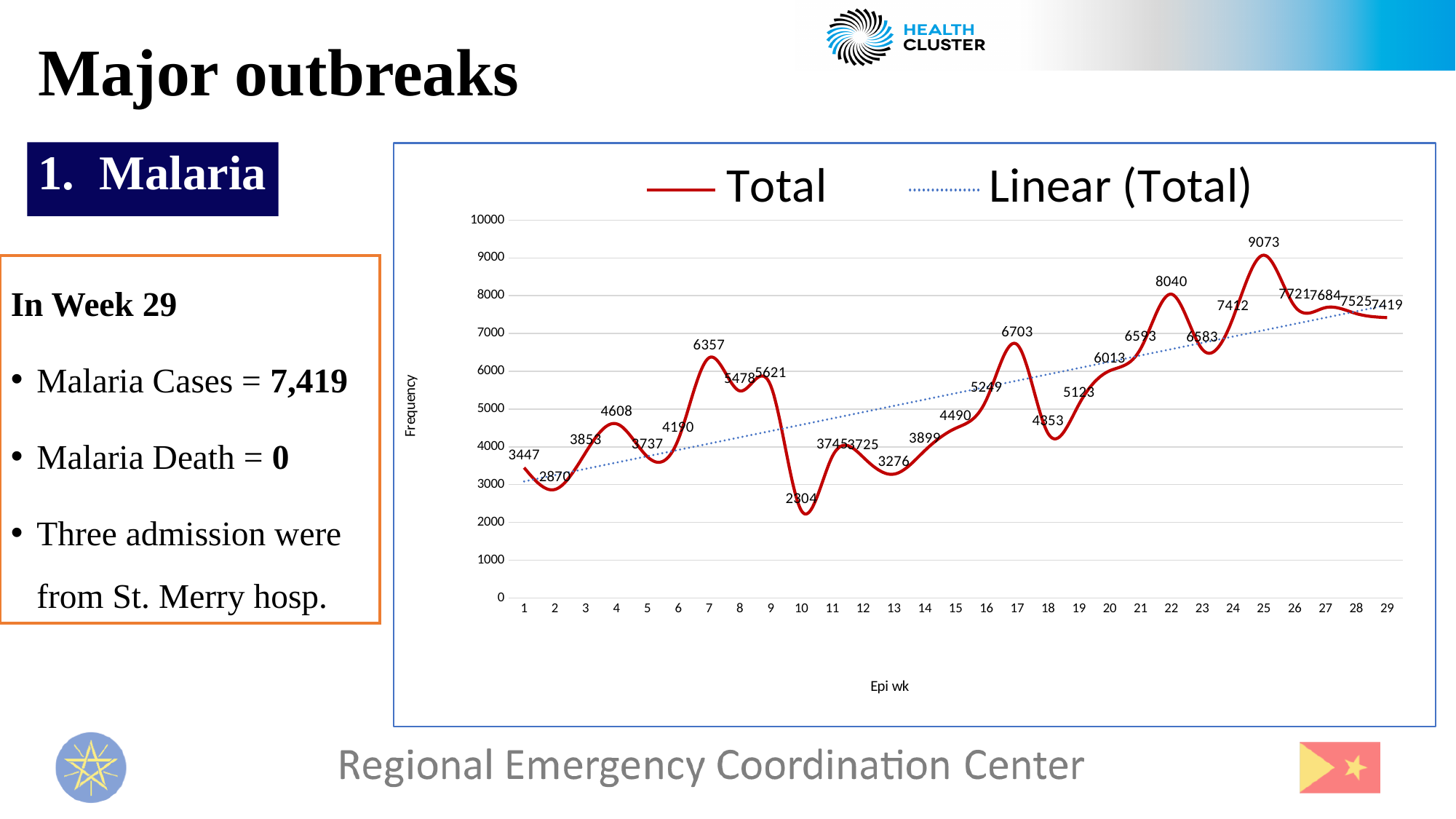
What is the difference between the Total values at epi week 25 and epi week 22? 1033 Which is larger, the Total value at epi week 7 or at epi week 17? epi week 17 What is the Total value at epi week 29? 7419 Is the Total value at epi week 2 greater or less than 3000? less Which epi week has the highest Total value? 25 How many epi weeks are plotted on the x axis? 29 What kind of chart is shown on the slide? line chart What is the Total value at epi week 10? 2304 Which epi week has the lowest Total value? 10 What is the Total value at epi week 22? 8040 What is the title of the x axis of the chart? Epi wk How many series does the legend list? 2